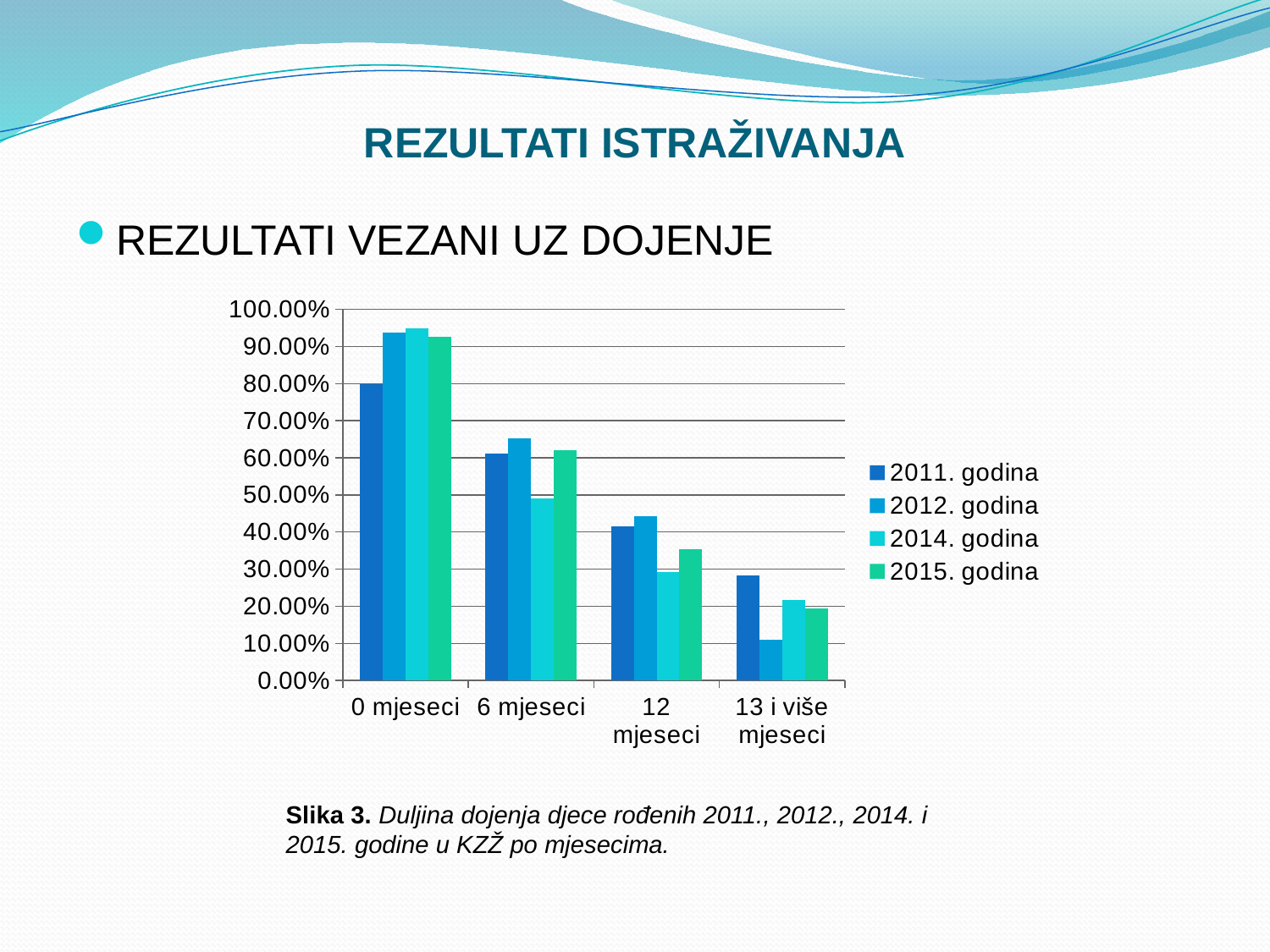
Is the value for 2011. godina at 12 mjeseci greater or less than 50.00%? less Is the value for 2011. godina at 13 i više mjeseci greater or less than 20.00%? greater Which series has the lowest value at 13 i više mjeseci? 2012. godina What kind of chart is shown on the slide? bar chart Is the value for 2012. godina at 0 mjeseci greater or less than 90.00%? greater Do the values for 2011. godina rise or fall from 0 mjeseci to 13 i više mjeseci? fall How many categories are shown on the x axis? 4 How many series does the legend list? 4 At 12 mjeseci, which is larger: the value for 2012. godina or for 2014. godina? 2012. godina Which series has the lowest value at 6 mjeseci? 2014. godina